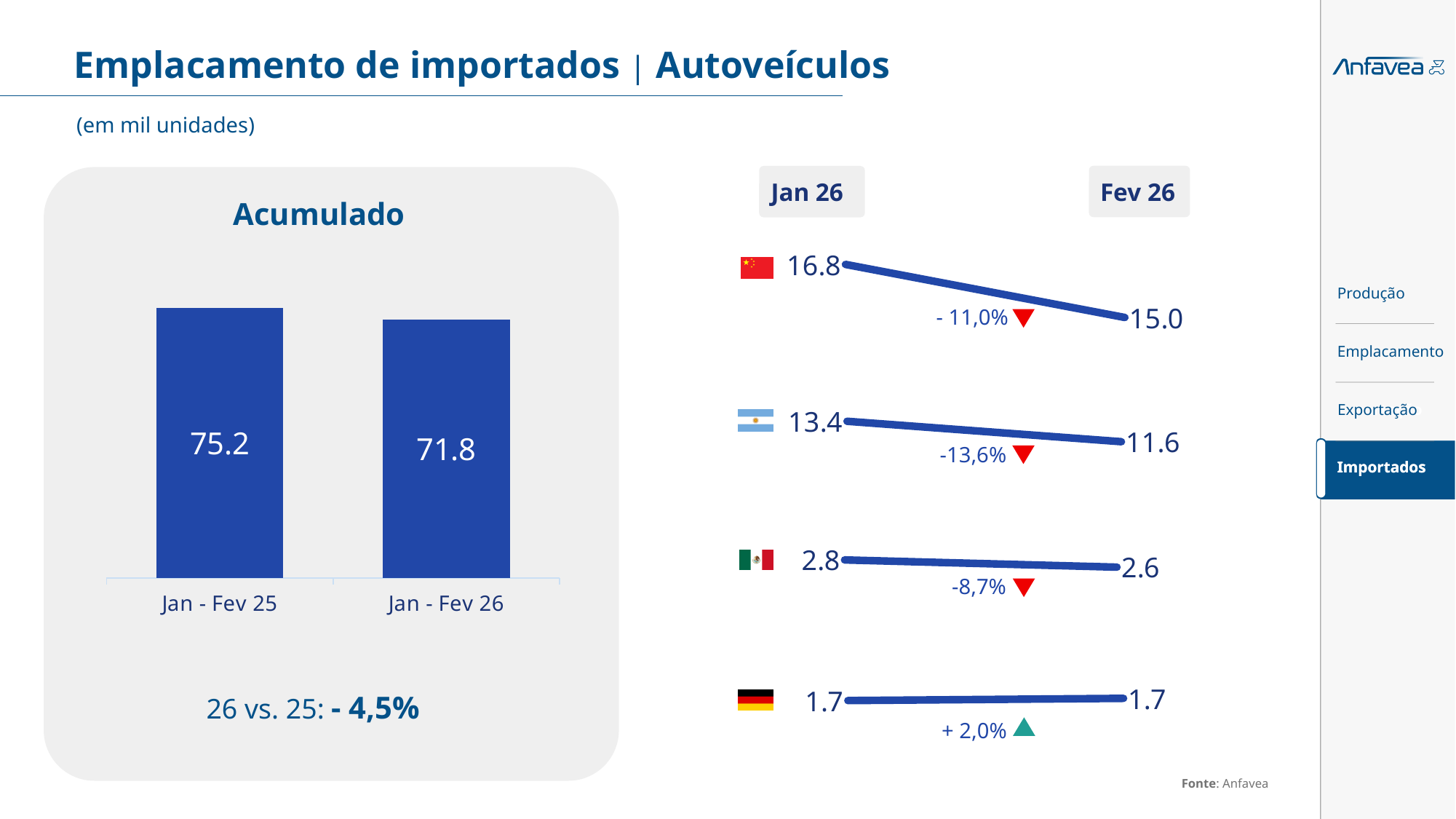
In the right-hand chart, what percentage change is shown for the third row (Mexican flag)? -8,7% In the Acumulado chart, what percentage change is shown for 26 vs. 25? - 4,5% In the right-hand chart, what is the Jan 26 value for the top row (Chinese flag)? 16.8 In the right-hand chart, which row has the highest Fev 26 value? The top row (Chinese flag), 15.0 How many bars does the Acumulado bar chart show? 2 In the Acumulado bar chart, what is the value for Jan - Fev 26? 71.8 In the Acumulado bar chart, what is the difference between the Jan - Fev 25 and Jan - Fev 26 values? 3.4 In the right-hand chart, which row is the only one showing an increase from Jan 26 to Fev 26? The bottom row (German flag), + 2,0% In the Acumulado bar chart, which period has the higher value? Jan - Fev 25 In the Acumulado bar chart, what is the value for Jan - Fev 25? 75.2 In the right-hand chart, what is the Fev 26 value for the second row (Argentine flag)? 11.6 What kind of chart is the Acumulado chart on the left? Bar chart